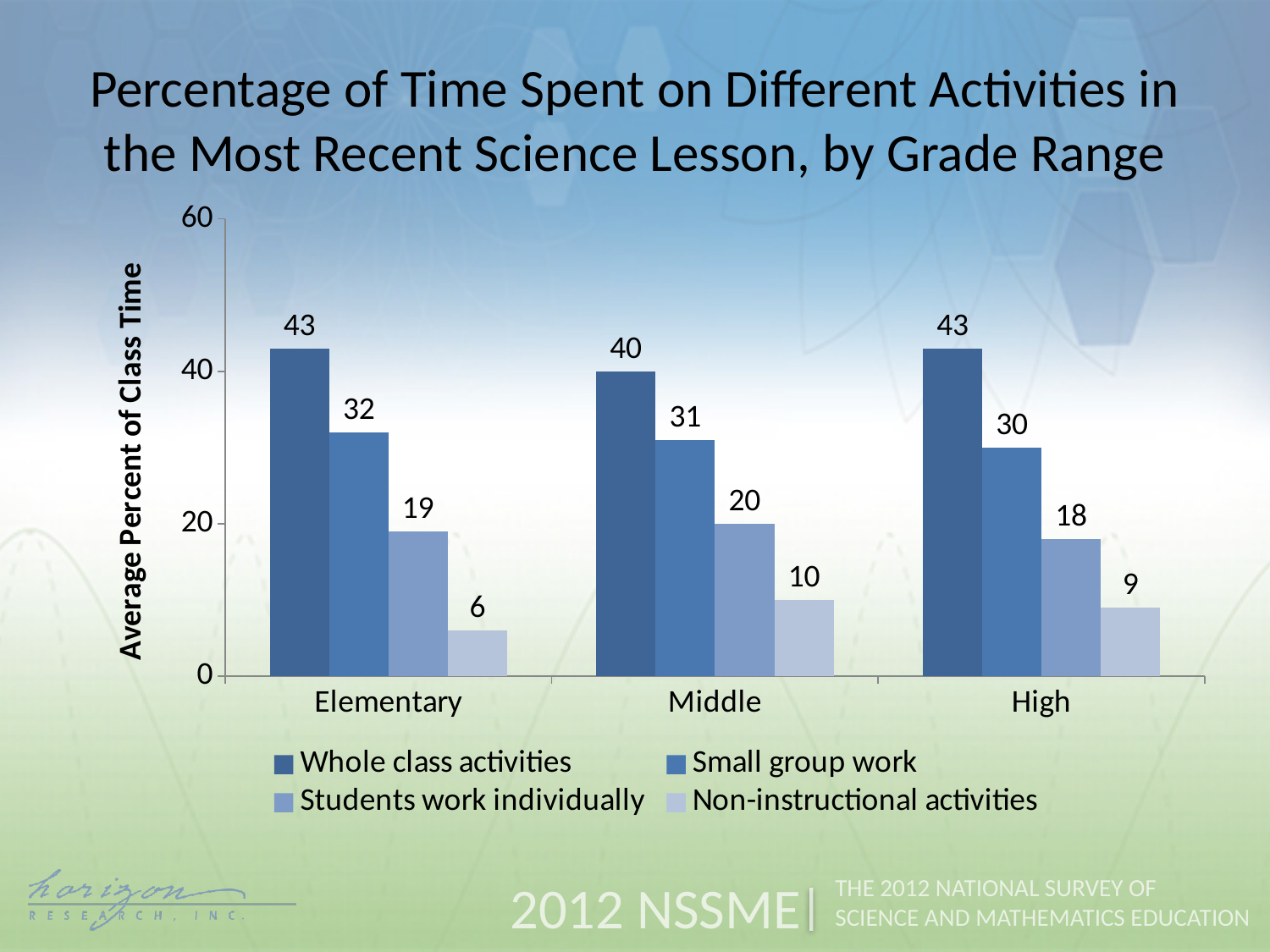
What kind of chart is shown on the slide? Bar chart Which is larger: Students work individually for Middle or Students work individually for High? Students work individually for Middle What is the value for Non-instructional activities in the Middle grade range? 10 What is the difference between Non-instructional activities for Elementary and for High? 3 How many series does the legend list? 4 What is the value for Whole class activities in the Elementary grade range? 43 Which grade range has the lowest value for Whole class activities? Middle What is the difference between Whole class activities and Small group work in the Middle grade range? 9 What is the value for Small group work in the High grade range? 30 What is the label of the y axis? Average Percent of Class Time Which grade range has the highest value for Small group work? Elementary How many grade ranges are shown on the x axis? 3